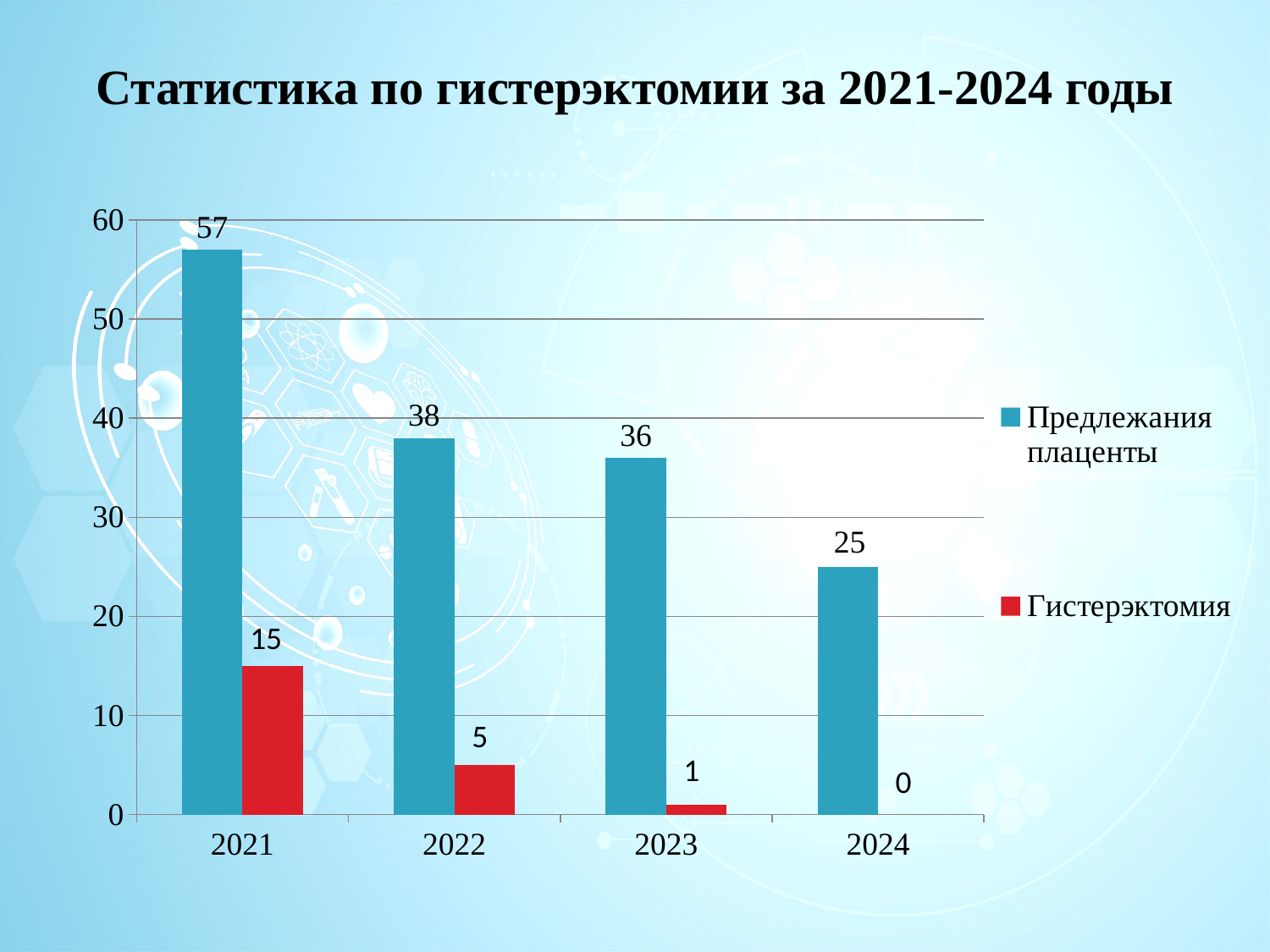
Do the Предлежания плаценты values rise or fall from 2021 to 2024? Fall What is the difference between Предлежания плаценты and Гистерэктомия in 2021? 42 How many years are shown on the x axis? 4 Which year has the lowest value for Гистерэктомия? 2024 How many series does the legend list? 2 What is the value for Предлежания плаценты in 2021? 57 What kind of chart is shown on the slide? Bar chart Which year has the highest value for Предлежания плаценты? 2021 Which is larger: Гистерэктомия in 2021 or Гистерэктомия in 2022? 2021 What is the value for Гистерэктомия in 2022? 5 What is the difference between the Предлежания плаценты values for 2022 and 2023? 2 What is the value for Гистерэктомия in 2024? 0